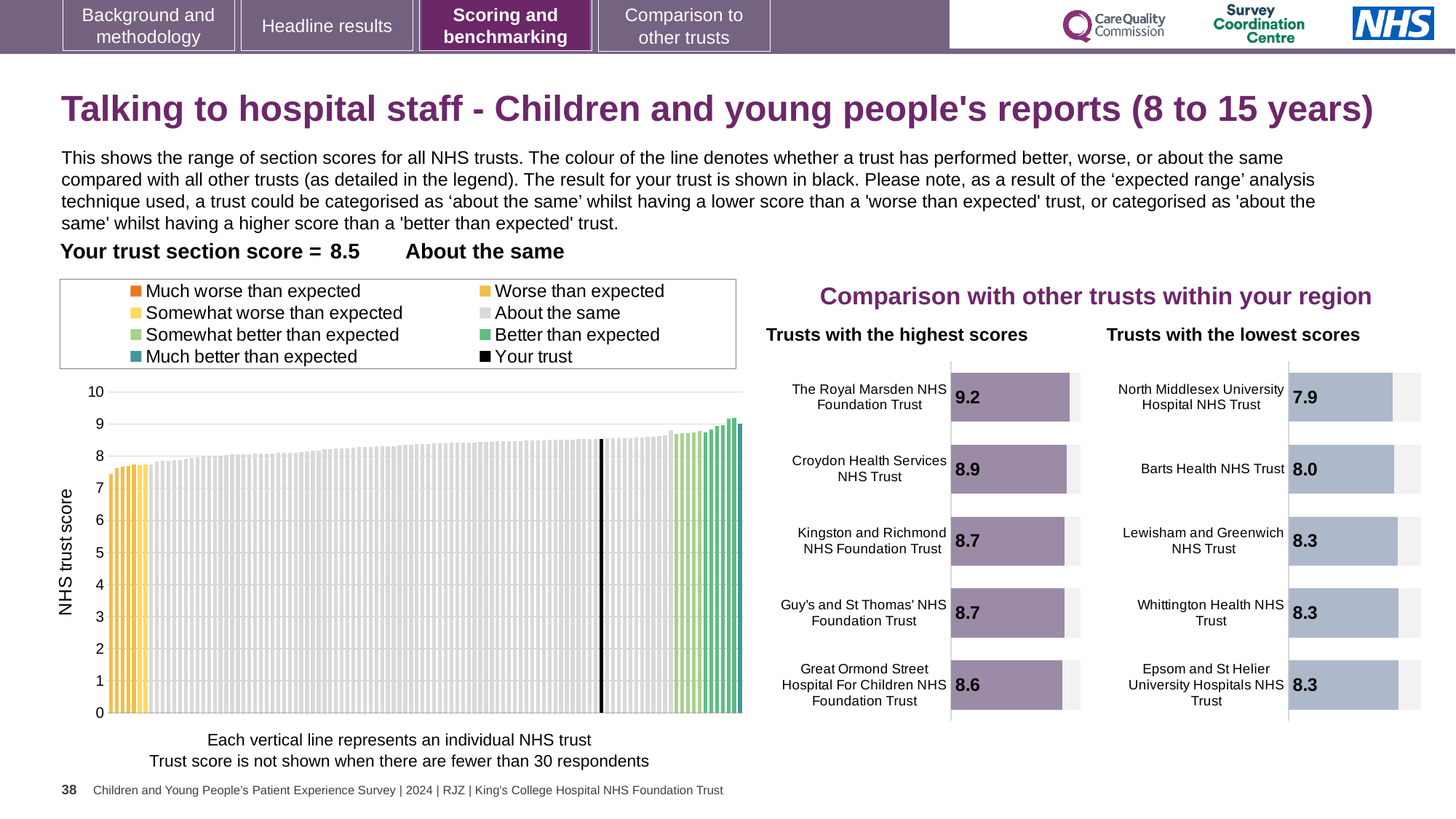
How many trusts are shown in the 'Trusts with the lowest scores' chart? 5 In the 'Trusts with the highest scores' chart, which trust has the highest score? The Royal Marsden NHS Foundation Trust In the 'Trusts with the highest scores' chart, what is the score for The Royal Marsden NHS Foundation Trust? 9.2 How many entries does the legend of the main NHS trust score chart list? 8 What is the section score for your trust shown in the main NHS trust score chart? 8.5 In the 'Trusts with the highest scores' chart, what is the difference between the scores of The Royal Marsden NHS Foundation Trust and Great Ormond Street Hospital For Children NHS Foundation Trust? 0.6 In the 'Trusts with the lowest scores' chart, what is the score for Barts Health NHS Trust? 8.0 In the 'Trusts with the highest scores' chart, what is the score for Great Ormond Street Hospital For Children NHS Foundation Trust? 8.6 In the 'Trusts with the lowest scores' chart, which trust has the lowest score? North Middlesex University Hospital NHS Trust In the 'Trusts with the lowest scores' chart, what is the difference between the scores of Barts Health NHS Trust and North Middlesex University Hospital NHS Trust? 0.1 In the main NHS trust score chart, do the bar values rise or fall from left to right? rise In the 'Trusts with the highest scores' chart, which has the higher score: Croydon Health Services NHS Trust or Kingston and Richmond NHS Foundation Trust? Croydon Health Services NHS Trust